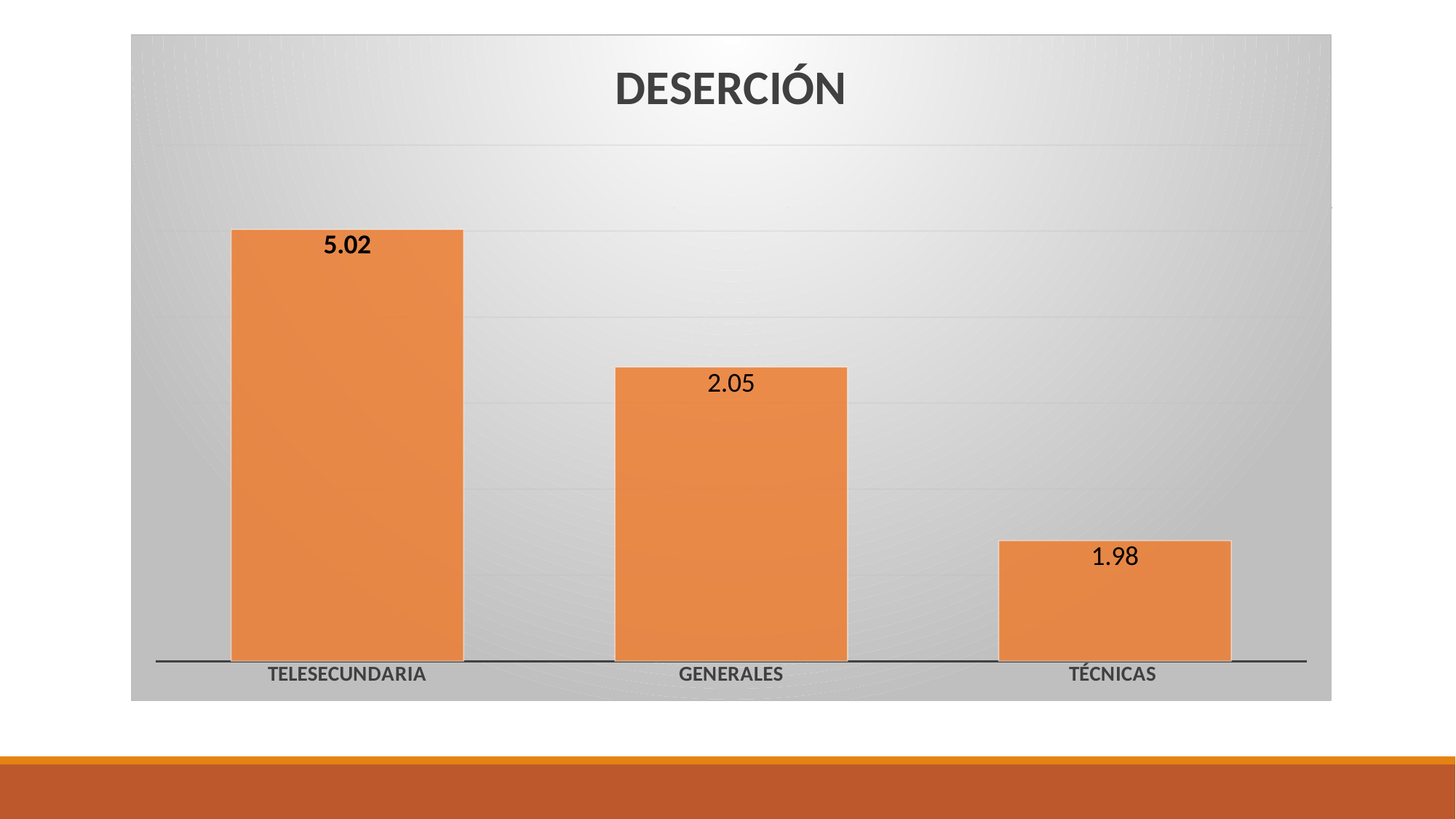
How many categories are shown in the chart? 3 What is the value for TELESECUNDARIA? 5.02 Which category has the lowest value? TÉCNICAS What is the value for TÉCNICAS? 1.98 What kind of chart is shown on the slide? Bar chart Which category has the highest value? TELESECUNDARIA What is the difference between the values for TELESECUNDARIA and GENERALES? 2.97 What is the difference between the values for GENERALES and TÉCNICAS? 0.07 What is the title of the chart? DESERCIÓN What is the value for GENERALES? 2.05 Which is larger, the value for TELESECUNDARIA or the value for TÉCNICAS? TELESECUNDARIA Do the values rise or fall from left to right across the categories? Fall